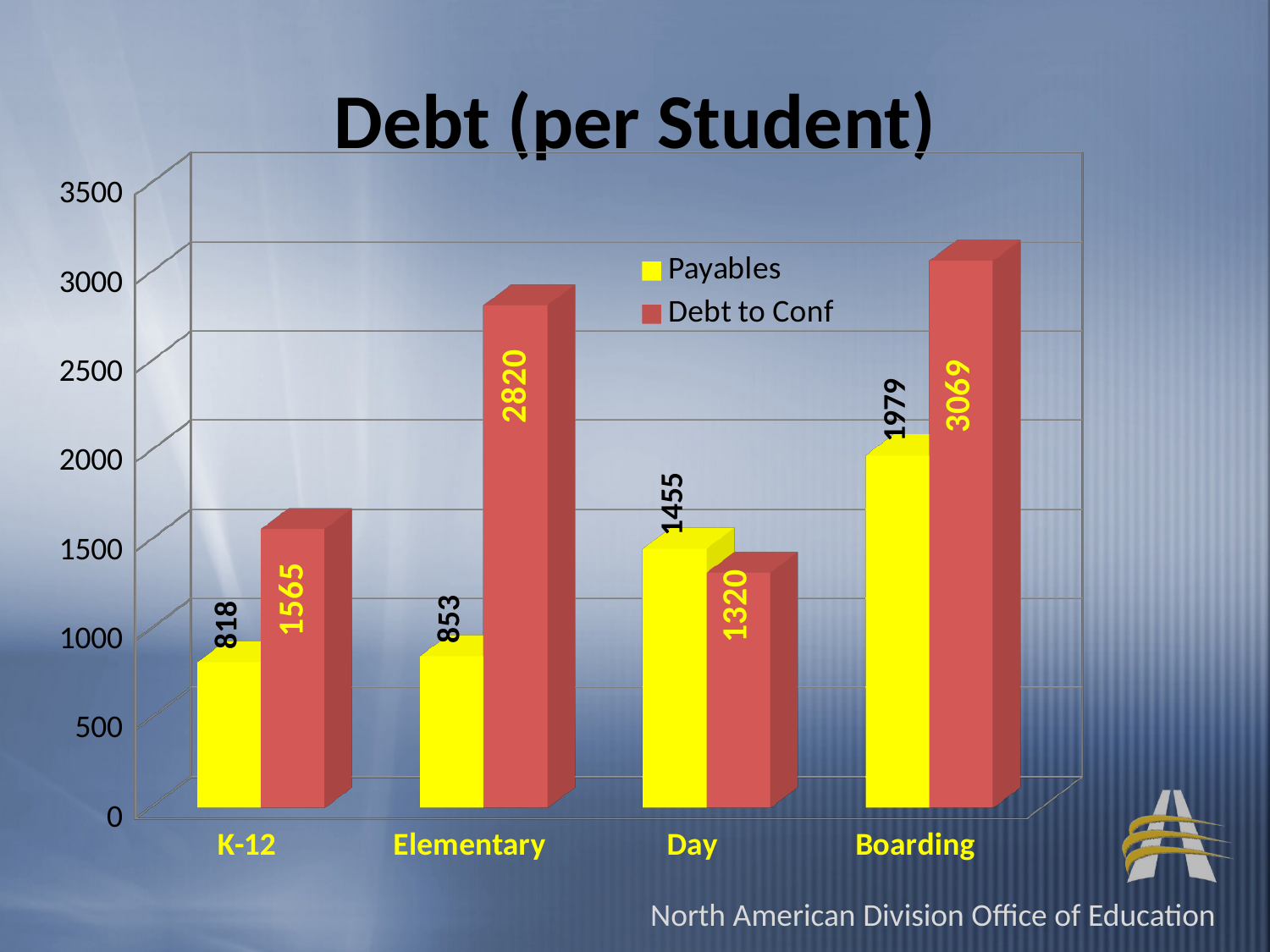
What is the Payables value for Boarding? 1979 For Day, which is larger: Payables or Debt to Conf? Payables What is the difference between Debt to Conf and Payables for Elementary? 1967 How many categories are shown on the x axis? 4 What is the Debt to Conf value for Elementary? 2820 How many series does the legend list? 2 Which category has the lowest Payables value? K-12 What is the Payables value for K-12? 818 What is the title of the chart? Debt (per Student) Which category has the highest Debt to Conf value? Boarding What is the Debt to Conf value for Day? 1320 What kind of chart is shown? Bar chart